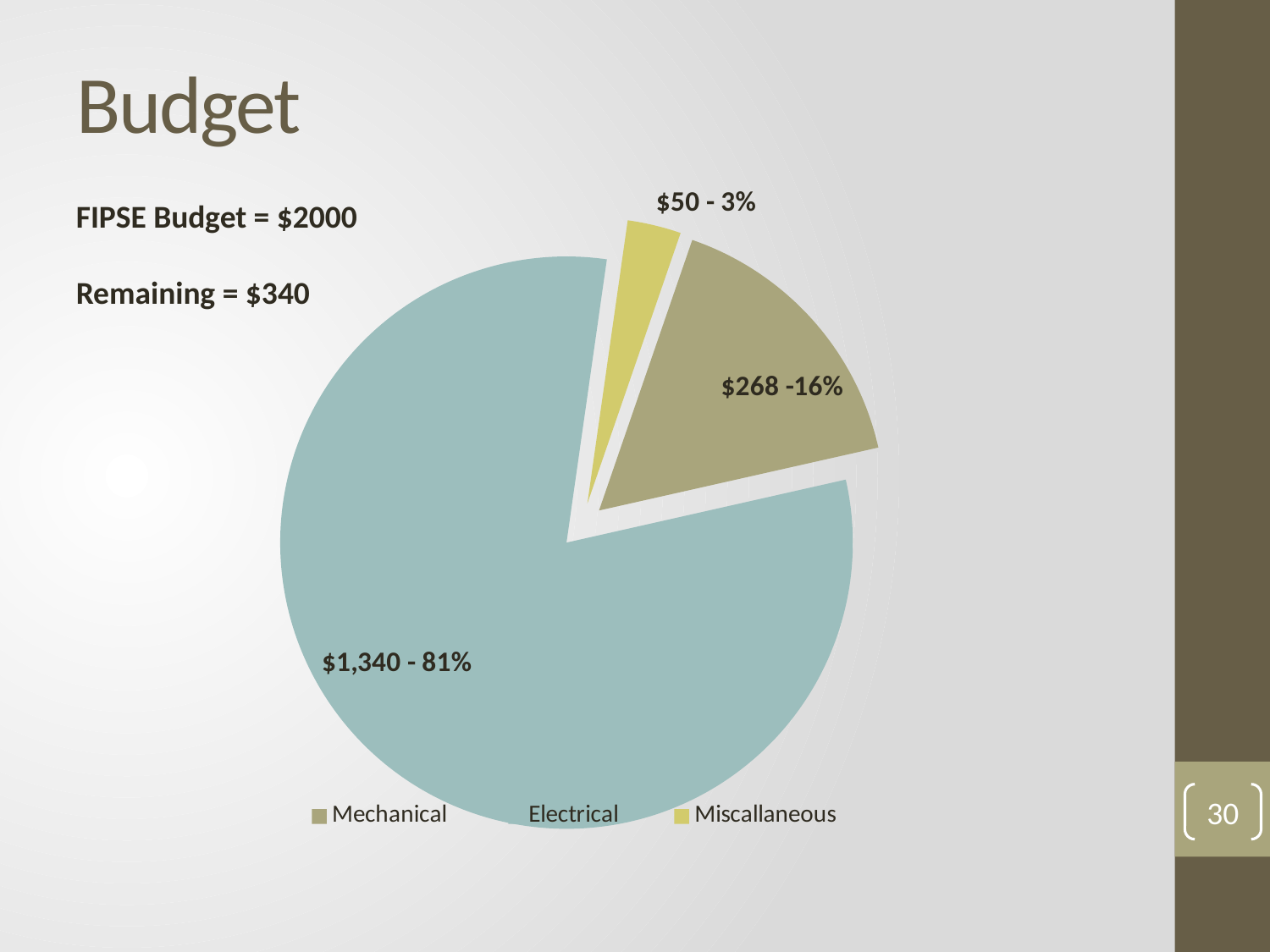
What is the difference in dollars between the Mechanical and Miscallaneous slices? $218 Which category has the largest slice of the pie? Electrical What three categories are listed in the chart legend? Mechanical, Electrical, Miscallaneous What percentage share of the pie does Electrical have? 81% Which is larger, the Mechanical slice or the Miscallaneous slice? Mechanical What kind of chart is shown on the slide? pie chart What dollar amount is shown for the Electrical slice? $1,340 What dollar amount is shown for the Mechanical slice? $268 Which category has the smallest slice of the pie? Miscallaneous What percentage share of the pie does Mechanical have? 16% What dollar amount is shown for the Miscallaneous slice? $50 How many slices does the pie chart have? 3